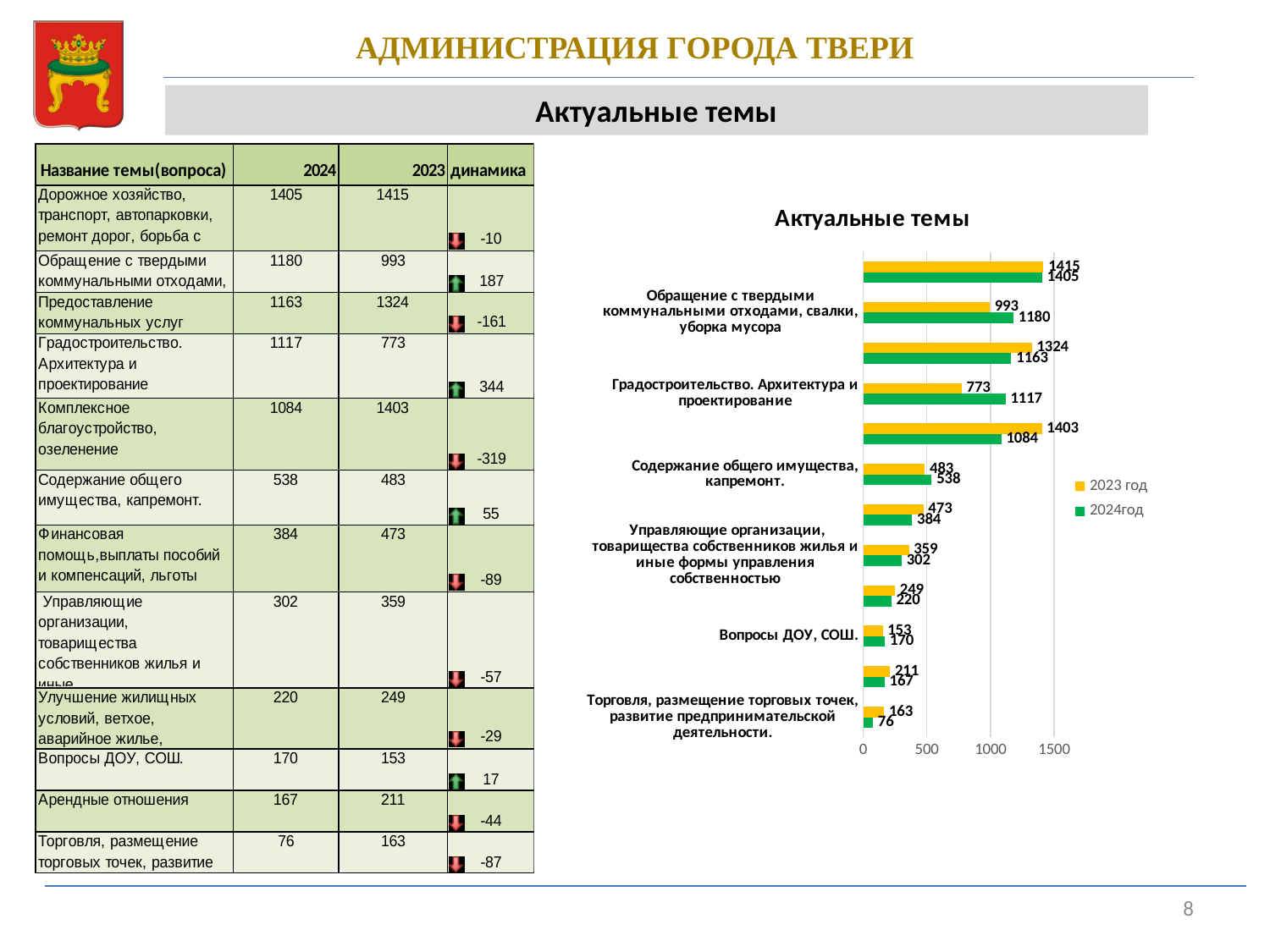
Which colour represents the 2023 год series in the chart? yellow What is the difference between the 2024год and 2023 год values for 'Обращение с твердыми коммунальными отходами, свалки, уборка мусора'? 187 What is the value for 2024год for 'Вопросы ДОУ, СОШ.'? 170 What is the value for 2023 год for 'Торговля, размещение торговых точек, развитие предпринимательской деятельности.'? 163 For 'Управляющие организации, товарищества собственников жилья и иные формы управления собственностью', which year has the larger value, 2023 год or 2024год? 2023 год How many series does the chart legend list? 2 Is the 2024год value for 'Градостроительство. Архитектура и проектирование' greater or less than 1000? greater By how much does the 2024год value exceed the 2023 год value for 'Градостроительство. Архитектура и проектирование'? 344 What is the value for 2024год for 'Обращение с твердыми коммунальными отходами, свалки, уборка мусора'? 1180 What is the value for 2023 год for 'Градостроительство. Архитектура и проектирование'? 773 What is the value for 2024год for 'Содержание общего имущества, капремонт.'? 538 What kind of chart is shown on the slide? bar chart